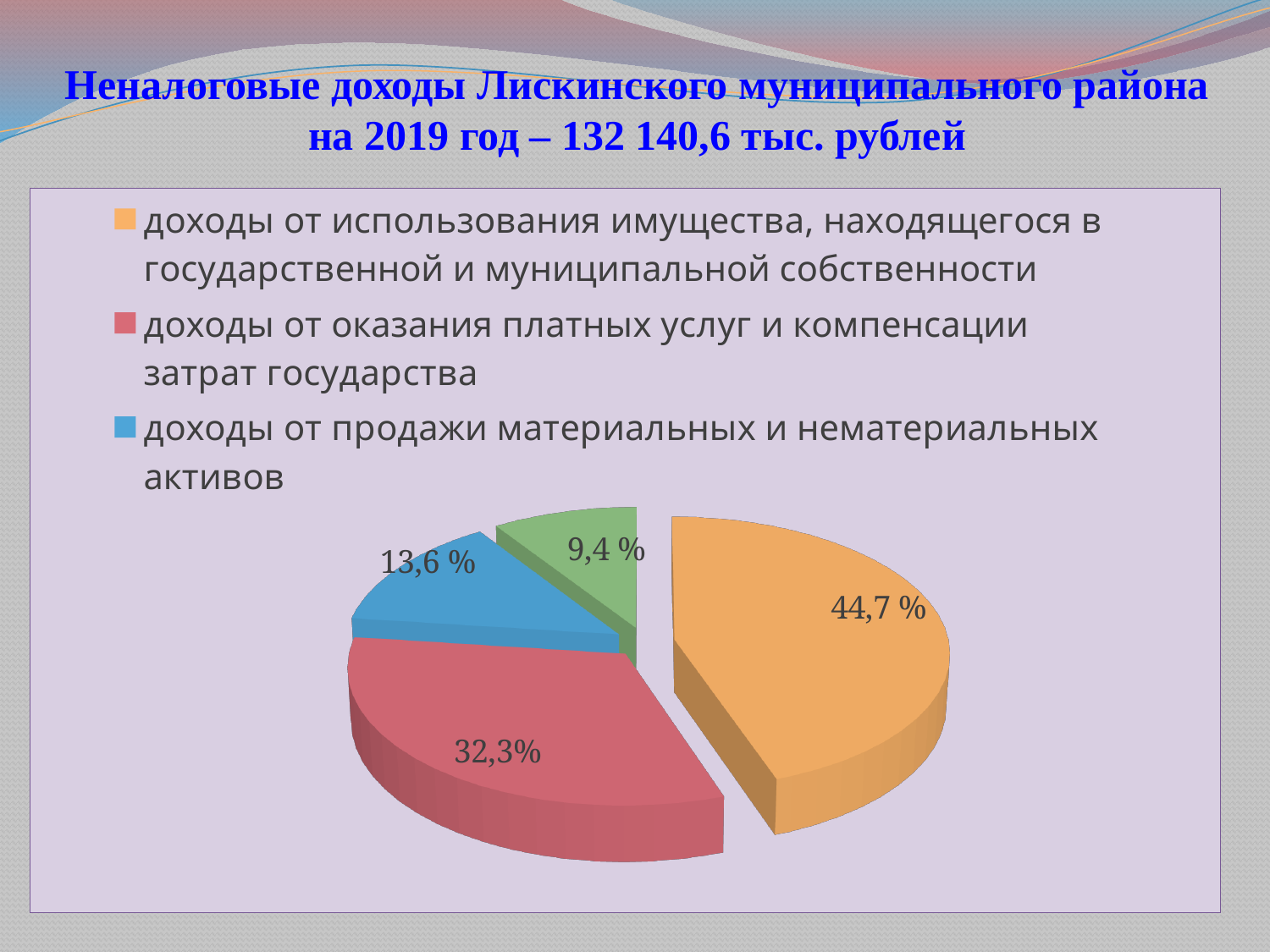
What share of the pie chart is taken by доходы от оказания платных услуг и компенсации затрат государства? 32,3% What colour is the slice for доходы от продажи материальных и нематериальных активов? blue What share of the pie chart is taken by доходы от использования имущества, находящегося в государственной и муниципальной собственности? 44,7 % What total amount of non-tax revenue for 2019 is stated in the slide title? 132 140,6 тыс. рублей Which is larger: the slice for доходы от оказания платных услуг и компенсации затрат государства or the slice for доходы от продажи материальных и нематериальных активов? доходы от оказания платных услуг и компенсации затрат государства How many slices does the pie chart have? 4 Which category has the largest slice in the pie chart? доходы от использования имущества, находящегося в государственной и муниципальной собственности By how many percentage points does the slice for доходы от использования имущества exceed the slice for доходы от оказания платных услуг и компенсации затрат государства? 12,4 % What share of the pie chart is taken by доходы от продажи материальных и нематериальных активов? 13,6 % What is the value of the smallest slice in the pie chart? 9,4 % What type of chart is shown on the slide? pie chart How many entries does the legend of the chart list? 3